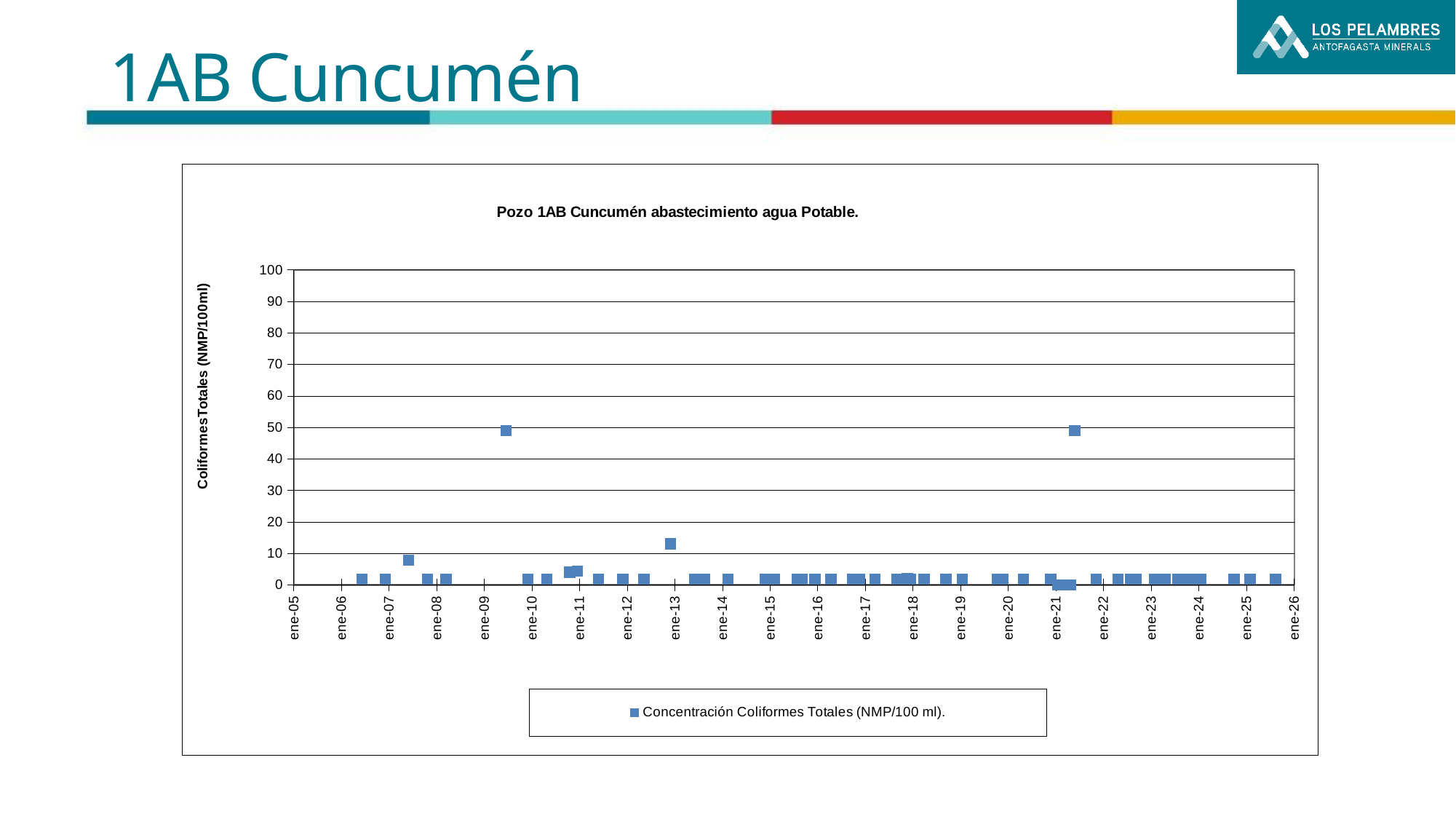
What is the title of the chart? Pozo 1AB Cuncumén abastecimiento agua Potable. Is the point plotted between ene-09 and ene-10 higher or lower than the point plotted near ene-13? higher What kind of chart is shown on the slide? scatter chart How many series does the legend list? 1 Is the value of the point plotted between ene-21 and ene-22 greater or less than 30? greater Is the value of the point plotted between ene-07 and ene-08 greater or less than 20? less Is the value of the point plotted between ene-09 and ene-10 greater or less than 40? greater What is the label on the vertical axis of the chart? ColiformesTotales (NMP/100ml) Is the value of the point plotted between ene-21 and ene-22 greater or less than the points plotted around ene-23? greater